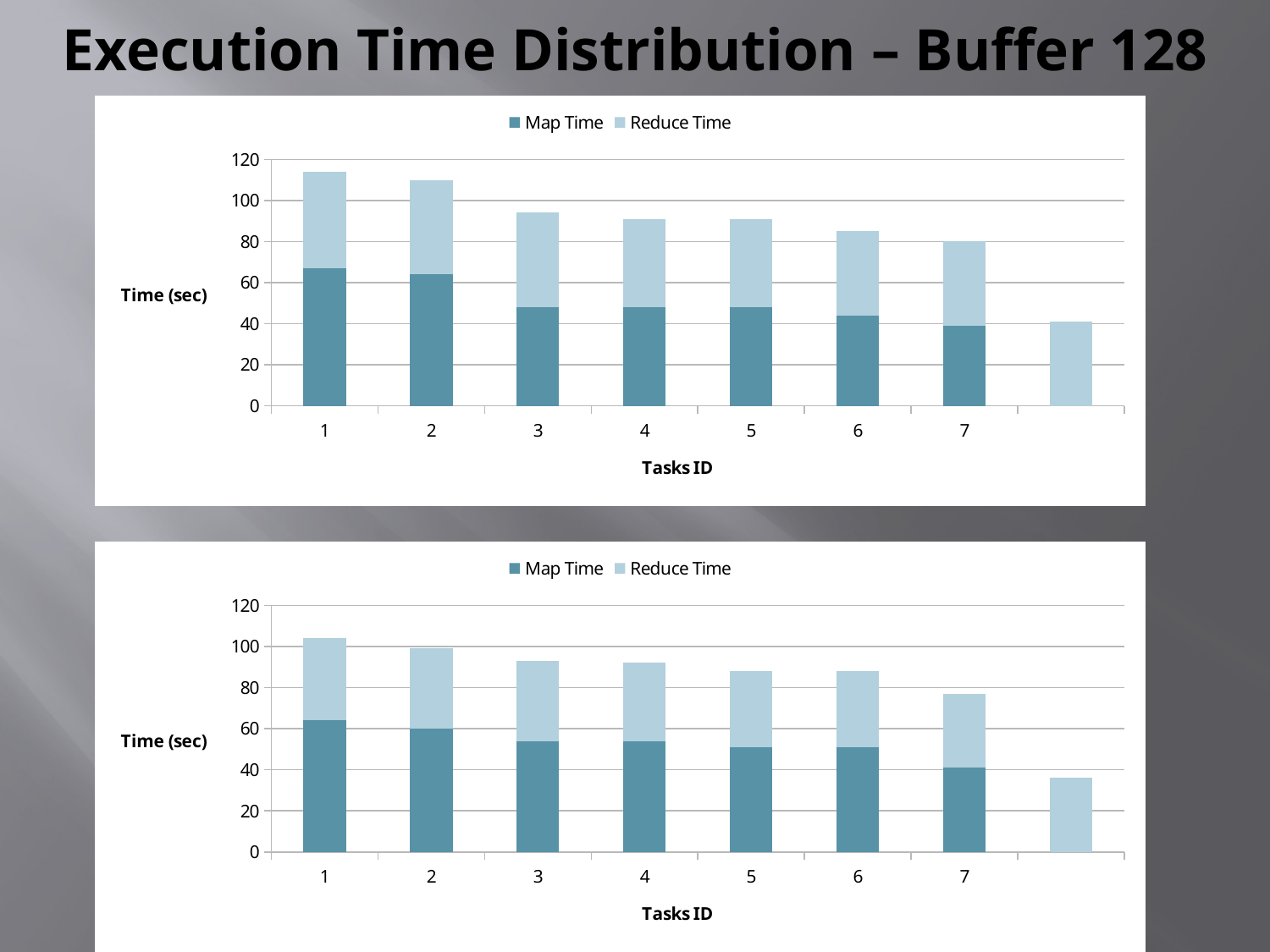
In the top chart, which labeled task ID has the lowest Map Time? 7 In the top chart, which labeled task ID has the tallest total stacked bar? 1 What kind of chart is the top chart on the slide? stacked bar chart In the bottom chart, does the Map Time rise or fall from task 1 to task 7? fall In the bottom chart, is the Map Time for task 7 greater or less than 60? less In the top chart, how many series does the legend list? 2 In the top chart, do the total stacked bars rise or fall from task 1 to task 7? fall In the bottom chart, is the total stacked bar for task 1 greater or less than 100? greater In the top chart, is the total stacked bar for task 7 greater or less than 100? less In the bottom chart, which has the larger total stacked bar, task 1 or task 7? task 1 What are the two legend entries in the bottom chart? Map Time and Reduce Time